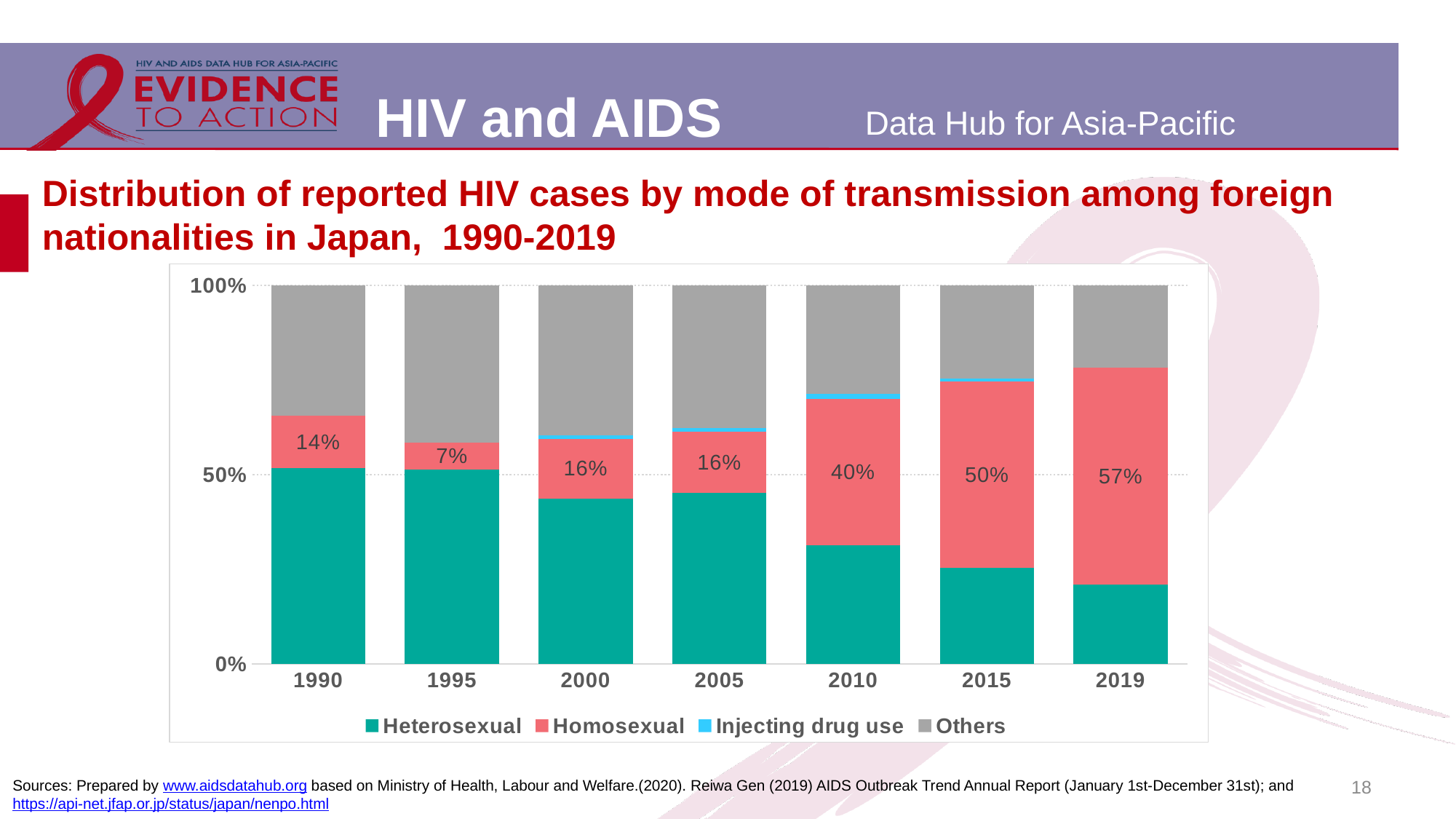
What type of chart is used on this slide? Stacked bar chart What is the Homosexual share shown for 2019? 57% How many modes of transmission does the legend list? 4 Is the Heterosexual share in 2019 greater or less than 50%? less What is the difference between the Homosexual share in 2015 and in 2010? 10 percentage points By how many percentage points did the Homosexual share increase from 1990 to 2019? 43 percentage points In which year is the Homosexual share the lowest? 1995 In which year is the Homosexual share the highest? 2019 How many years are shown on the x axis of the chart? 7 Which year has a larger Homosexual share, 2010 or 2015? 2015 What is the Homosexual share shown for 1995? 7% What percentage of reported HIV cases among foreign nationalities in Japan were attributed to homosexual transmission in 1990? 14%